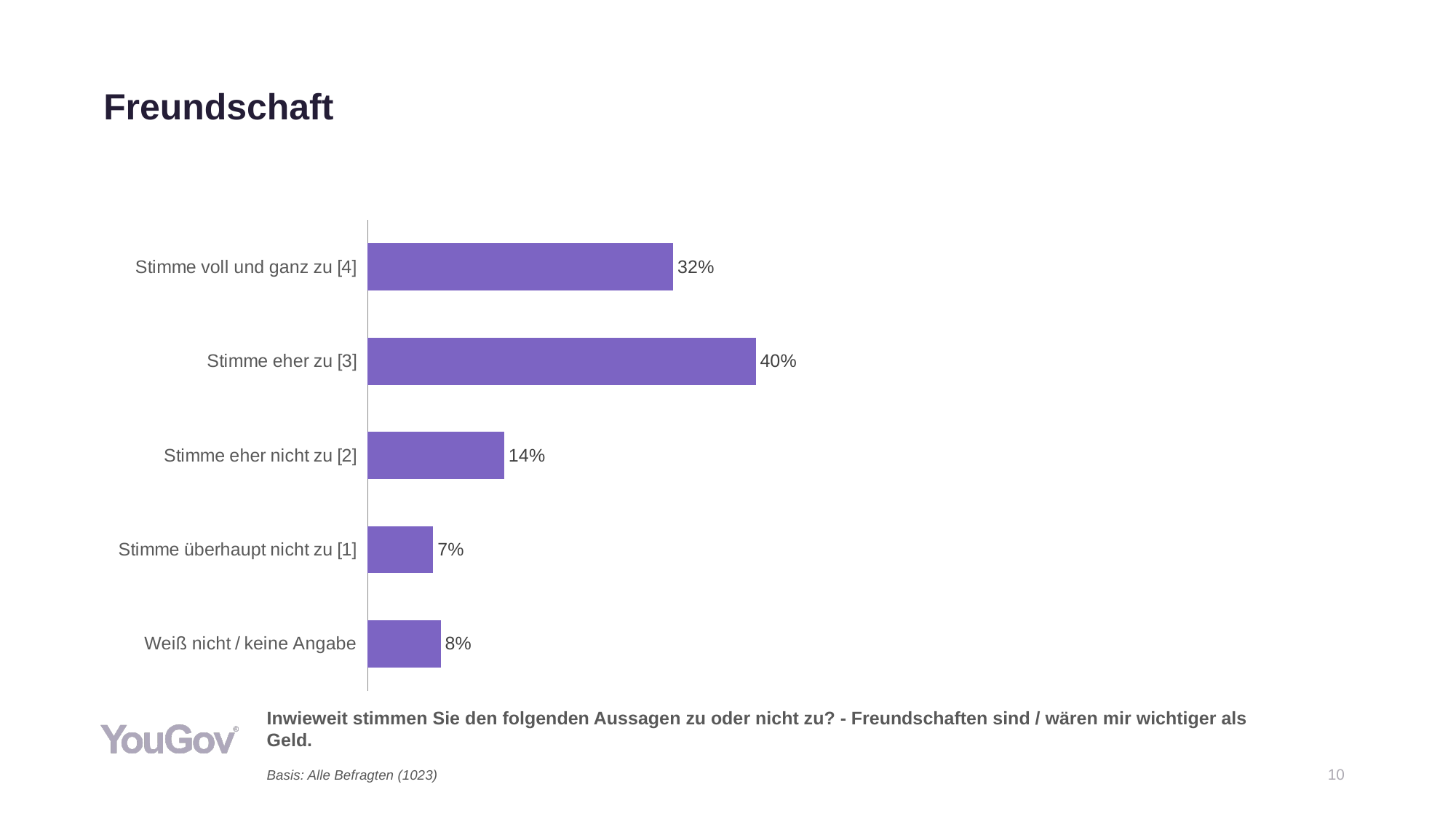
What is the title of the slide? Freundschaft What kind of chart is shown on the slide? Bar chart What is the value for "Weiß nicht / keine Angabe"? 8% How many categories are shown in the chart? 5 Which category has the lowest value? Stimme überhaupt nicht zu [1] What is the difference between the values for "Stimme eher zu [3]" and "Stimme voll und ganz zu [4]"? 8% What is the value for "Stimme voll und ganz zu [4]"? 32% Which category has the highest value? Stimme eher zu [3] What is the value for "Stimme eher zu [3]"? 40% What is the value for "Stimme eher nicht zu [2]"? 14% What is the value for "Stimme überhaupt nicht zu [1]"? 7% Which is larger, the value for "Stimme eher nicht zu [2]" or for "Weiß nicht / keine Angabe"? Stimme eher nicht zu [2]